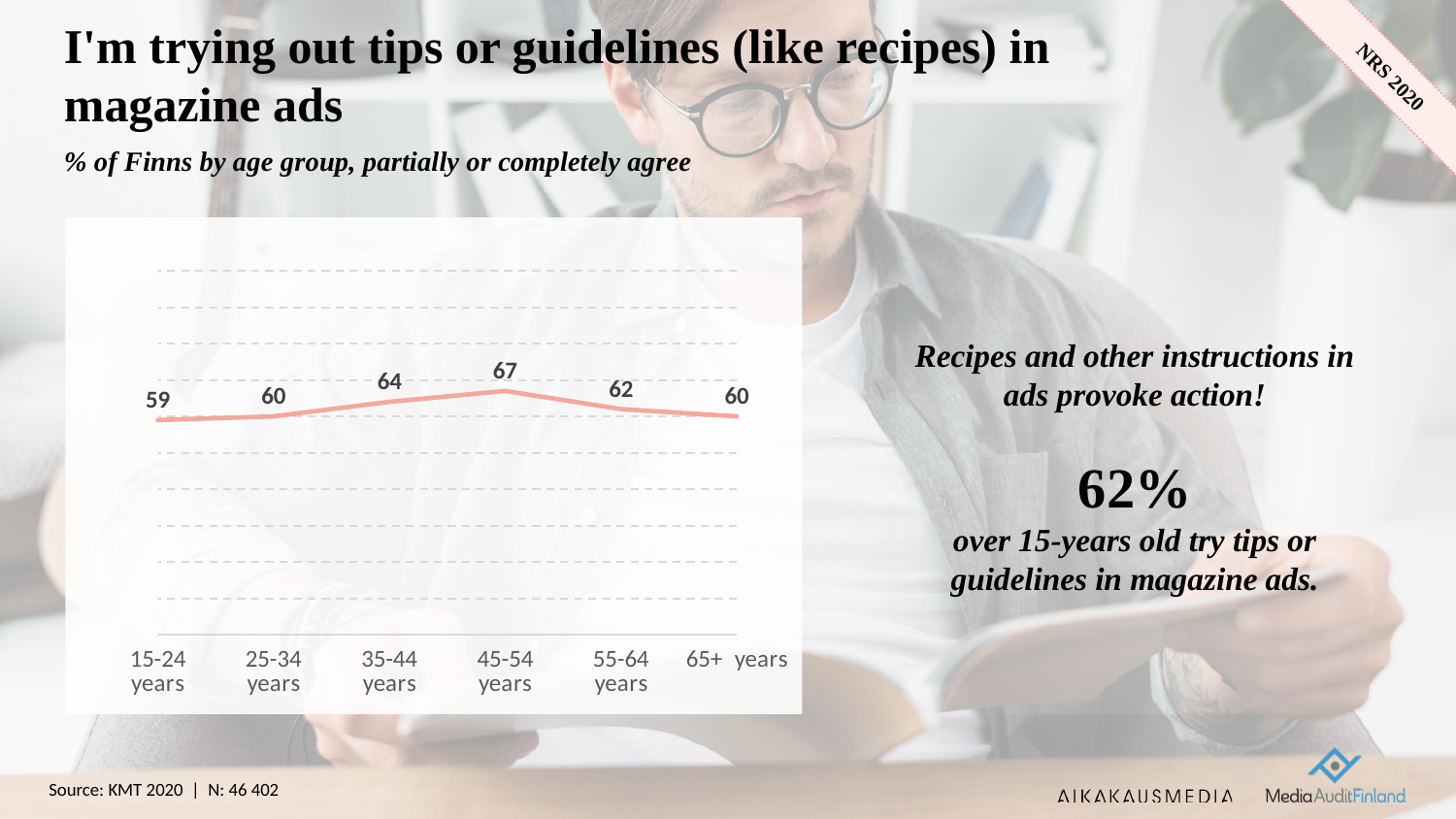
What is the difference between the values for the 35-44 years and 55-64 years age groups? 2 What kind of chart is shown on the slide? Line chart How many age groups are plotted on the chart? 6 Do the values rise or fall from the 45-54 years group to the 65+ years group? Fall Which is larger, the value for 35-44 years or the value for 65+ years? 35-44 years What is the value for the 15-24 years age group? 59 What is the value for the 55-64 years age group? 62 What is the value for the 35-44 years age group? 64 Which age group has the lowest value? 15-24 years What is the difference between the values for the 45-54 years and 15-24 years age groups? 8 Which age group has the highest value? 45-54 years What is the value for the 45-54 years age group? 67